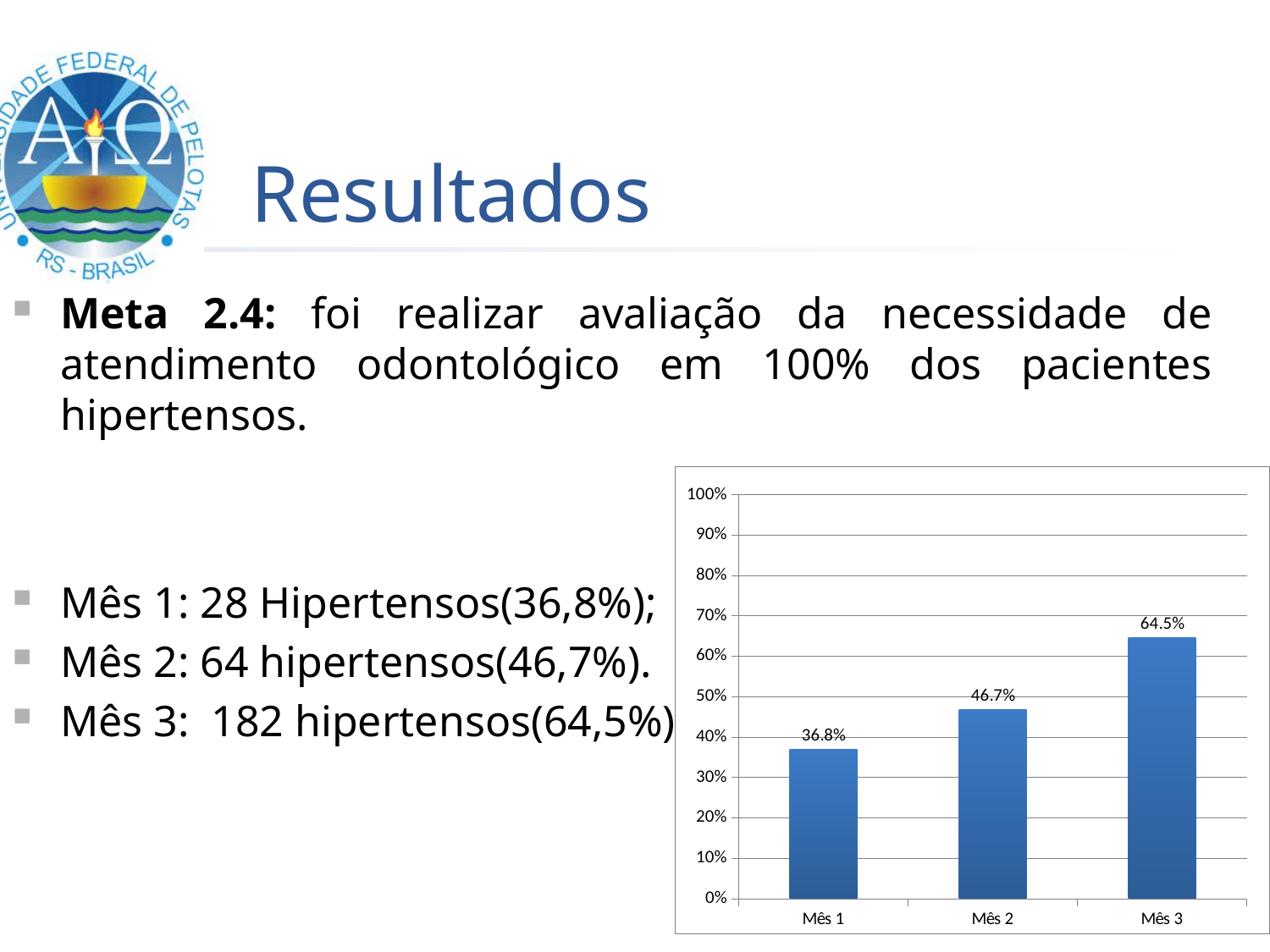
What is the value shown for Mês 2 in the chart? 46.7% How many categories are shown on the x axis of the chart? 3 What kind of chart is shown on the slide? bar chart Which is larger, the value for Mês 2 or the value for Mês 3? Mês 3 What is the value shown for Mês 1 in the chart? 36.8% What is the difference between the values for Mês 3 and Mês 1? 27.7% Is the value for Mês 2 greater or less than 50%? less Which month has the lowest value in the chart? Mês 1 Which month has the highest value in the chart? Mês 3 Do the values rise or fall from Mês 1 to Mês 3? rise What is the difference between the values for Mês 2 and Mês 1? 9.9% What is the value shown for Mês 3 in the chart? 64.5%